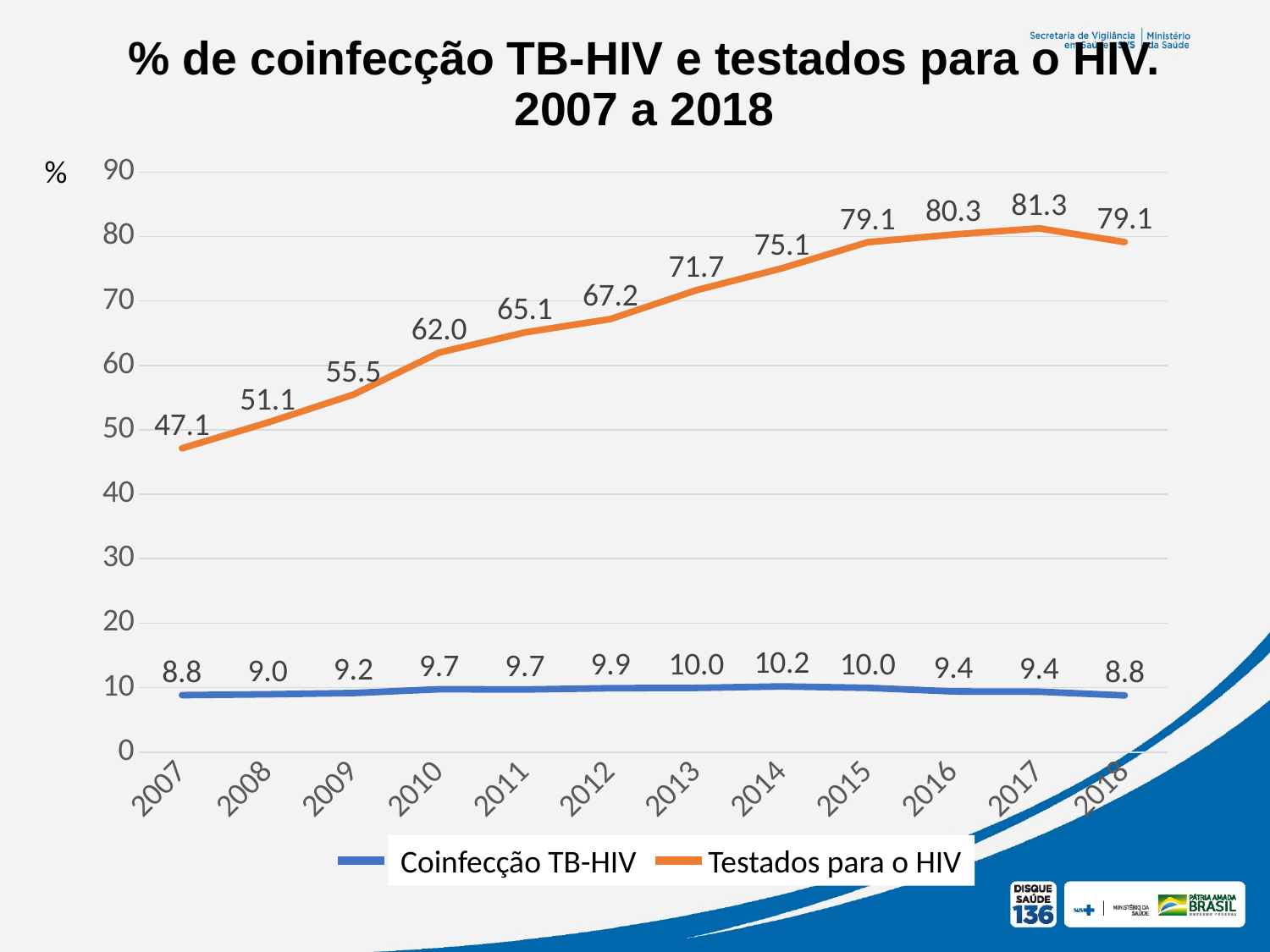
What colour is the line for Testados para o HIV? Orange What is the value for Testados para o HIV in 2007? 47.1 Does Testados para o HIV rise or fall from 2007 to 2017? Rise What is the value for Testados para o HIV in 2017? 81.3 How many series does the legend list? 2 What kind of chart is shown? Line chart What is the difference between Testados para o HIV in 2018 and in 2007? 32.0 In which year is Testados para o HIV highest? 2017 In which year is Testados para o HIV lowest? 2007 How many years are shown on the x axis? 12 What is the value for Coinfecção TB-HIV in 2014? 10.2 Which is larger: Coinfecção TB-HIV in 2014 or in 2018? 2014